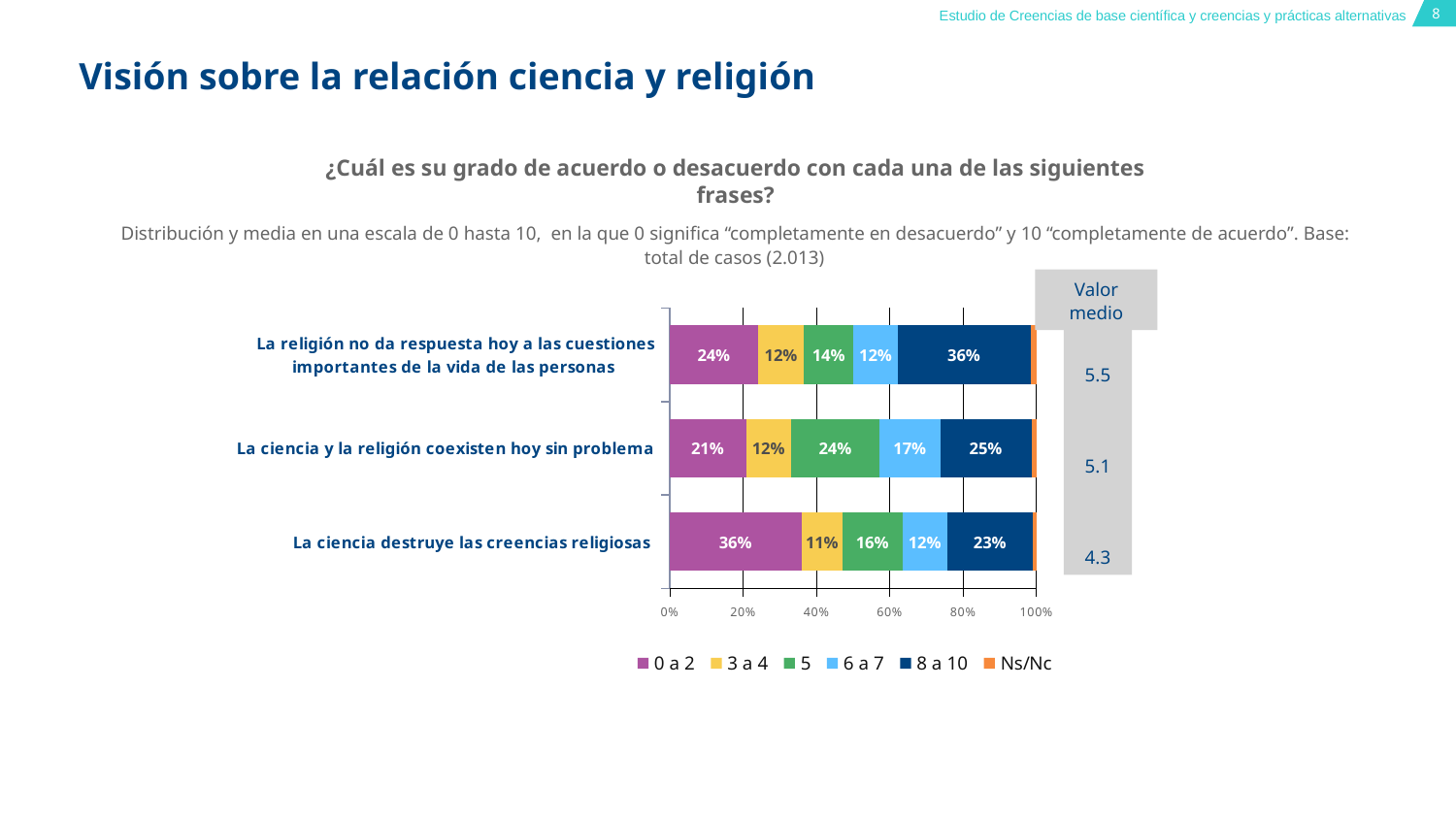
What is the share of respondents scoring 5 for "La ciencia y la religión coexisten hoy sin problema"? 24% Which statement has a larger share of respondents scoring 5: "La ciencia y la religión coexisten hoy sin problema" or "La ciencia destruye las creencias religiosas"? La ciencia y la religión coexisten hoy sin problema How many series does the legend list? 6 How many statements are shown in the chart? 3 What is the difference in the 8 a 10 share between "La religión no da respuesta hoy a las cuestiones importantes de la vida de las personas" and "La ciencia destruye las creencias religiosas"? 13 percentage points What is the 6 a 7 share for "La ciencia y la religión coexisten hoy sin problema"? 17% What kind of chart is shown on the slide? Stacked bar chart Which statement has the lowest share of 0 a 2 scores? La ciencia y la religión coexisten hoy sin problema What percentage of respondents gave a score of 8 a 10 to the statement "La religión no da respuesta hoy a las cuestiones importantes de la vida de las personas"? 36% Which statement has the highest share of 8 a 10 scores? La religión no da respuesta hoy a las cuestiones importantes de la vida de las personas What percentage gave a score of 0 a 2 to "La ciencia destruye las creencias religiosas"? 36% What is the Valor medio shown for "La ciencia destruye las creencias religiosas"? 4.3